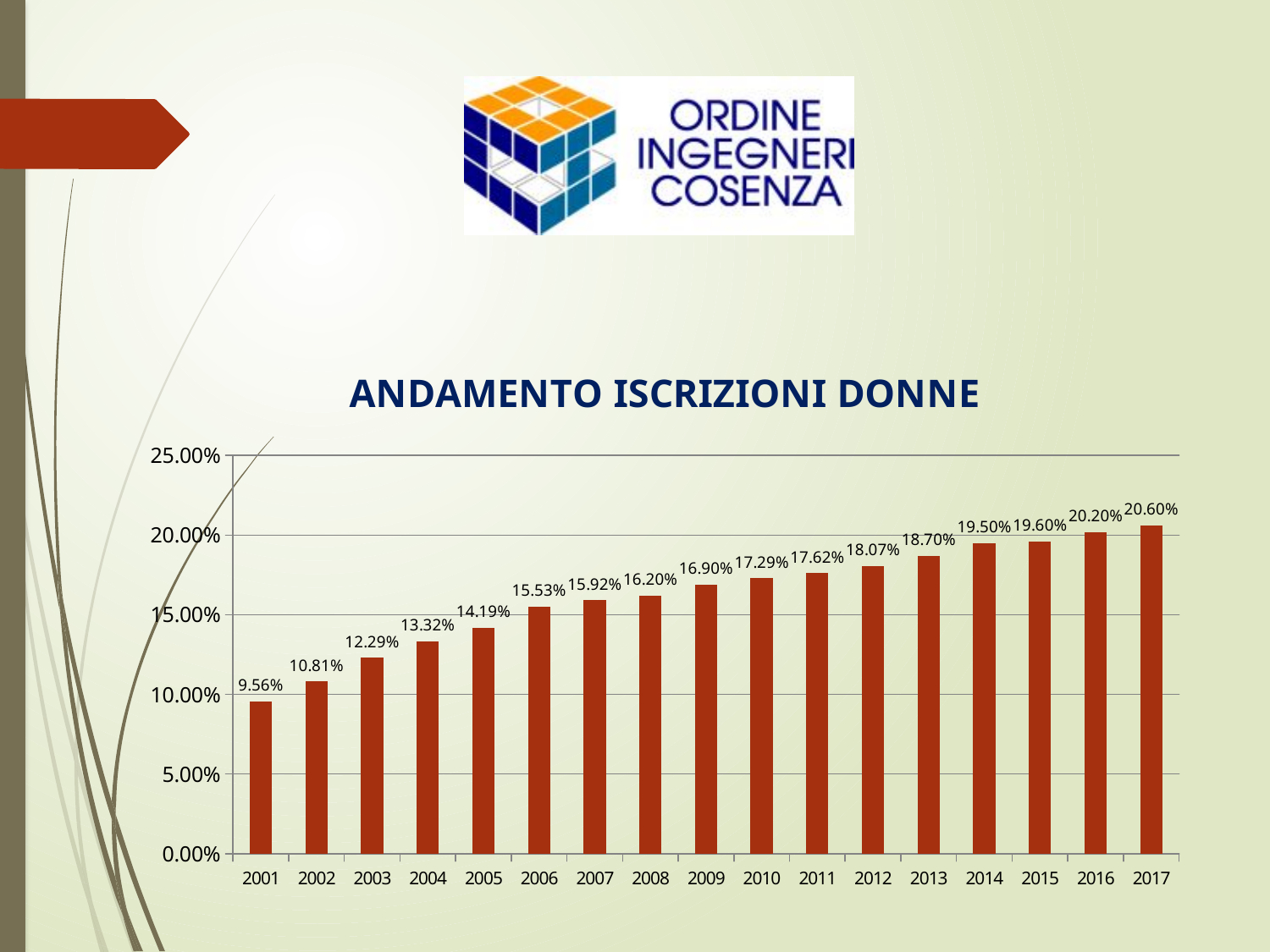
What is the difference between the values for 2017 and 2001? 11.04% What is the value for 2009? 16.90% What is the title of the chart? ANDAMENTO ISCRIZIONI DONNE Do the values rise or fall from 2001 to 2017? rise Which year has the lowest value? 2001 Is the value for 2013 greater or less than 20.00%? less What is the value for 2014? 19.50% What is the value for 2001? 9.56% Which year has the highest value? 2017 What kind of chart is shown? bar chart Which is larger, the value for 2005 or the value for 2008? 2008 How many years are shown on the x axis? 17